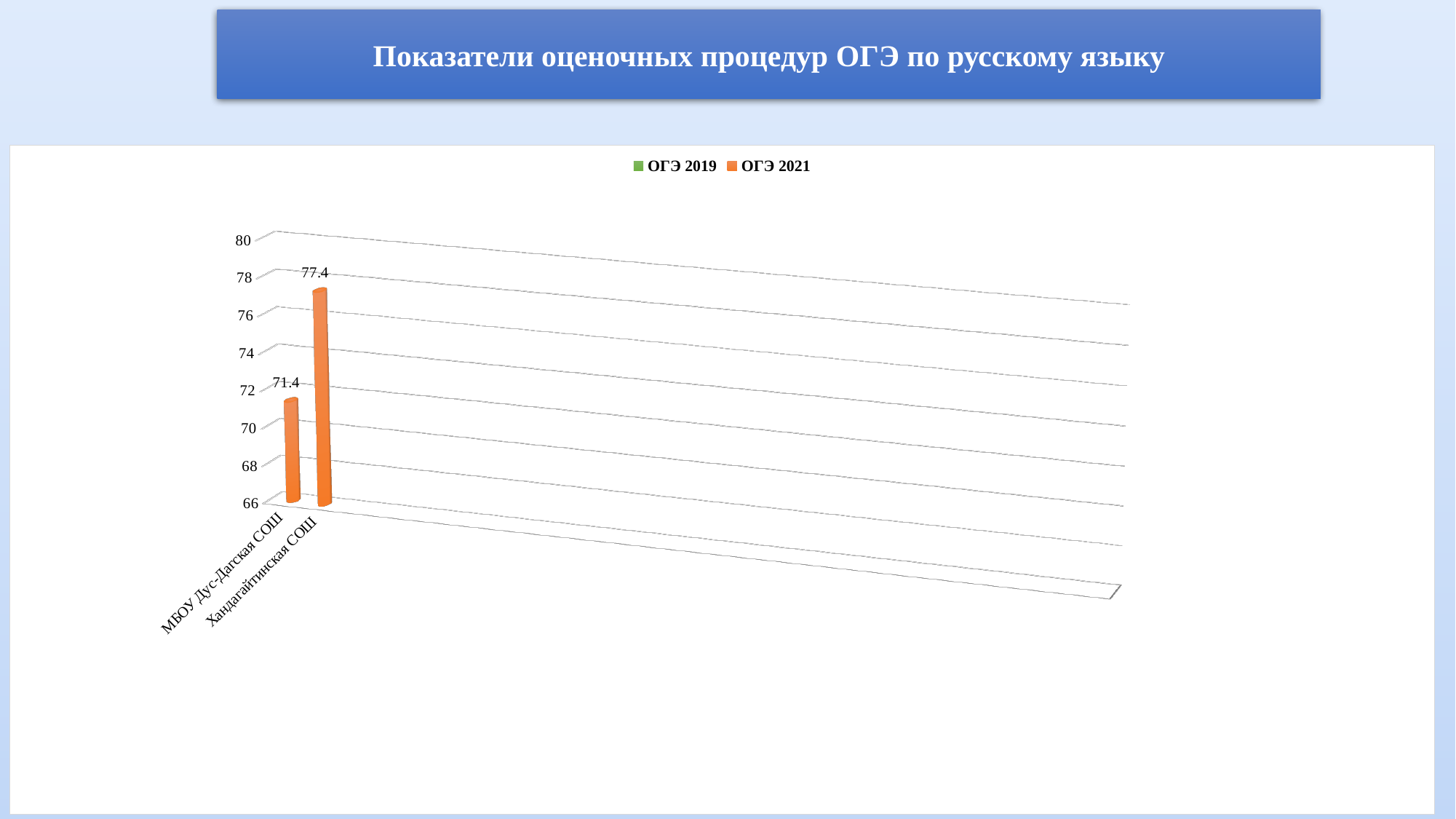
Is the ОГЭ 2021 value for МБОУ Дус-Дагская СОШ greater or less than 74? less What colour represents the ОГЭ 2021 series in the legend? Orange Is the ОГЭ 2021 value for Хандагайтинская СОШ greater or less than 76? greater How many schools are shown on the x axis of the chart? 2 What kind of chart is shown on the slide? Bar chart How many series does the chart legend list? 2 What is the ОГЭ 2021 value for Хандагайтинская СОШ? 77.4 Which school has the highest ОГЭ 2021 value? Хандагайтинская СОШ What is the ОГЭ 2021 value for МБОУ Дус-Дагская СОШ? 71.4 Which is larger: the ОГЭ 2021 value for МБОУ Дус-Дагская СОШ or for Хандагайтинская СОШ? Хандагайтинская СОШ What is the difference between the ОГЭ 2021 values for Хандагайтинская СОШ and МБОУ Дус-Дагская СОШ? 6 Which school has the lowest ОГЭ 2021 value? МБОУ Дус-Дагская СОШ